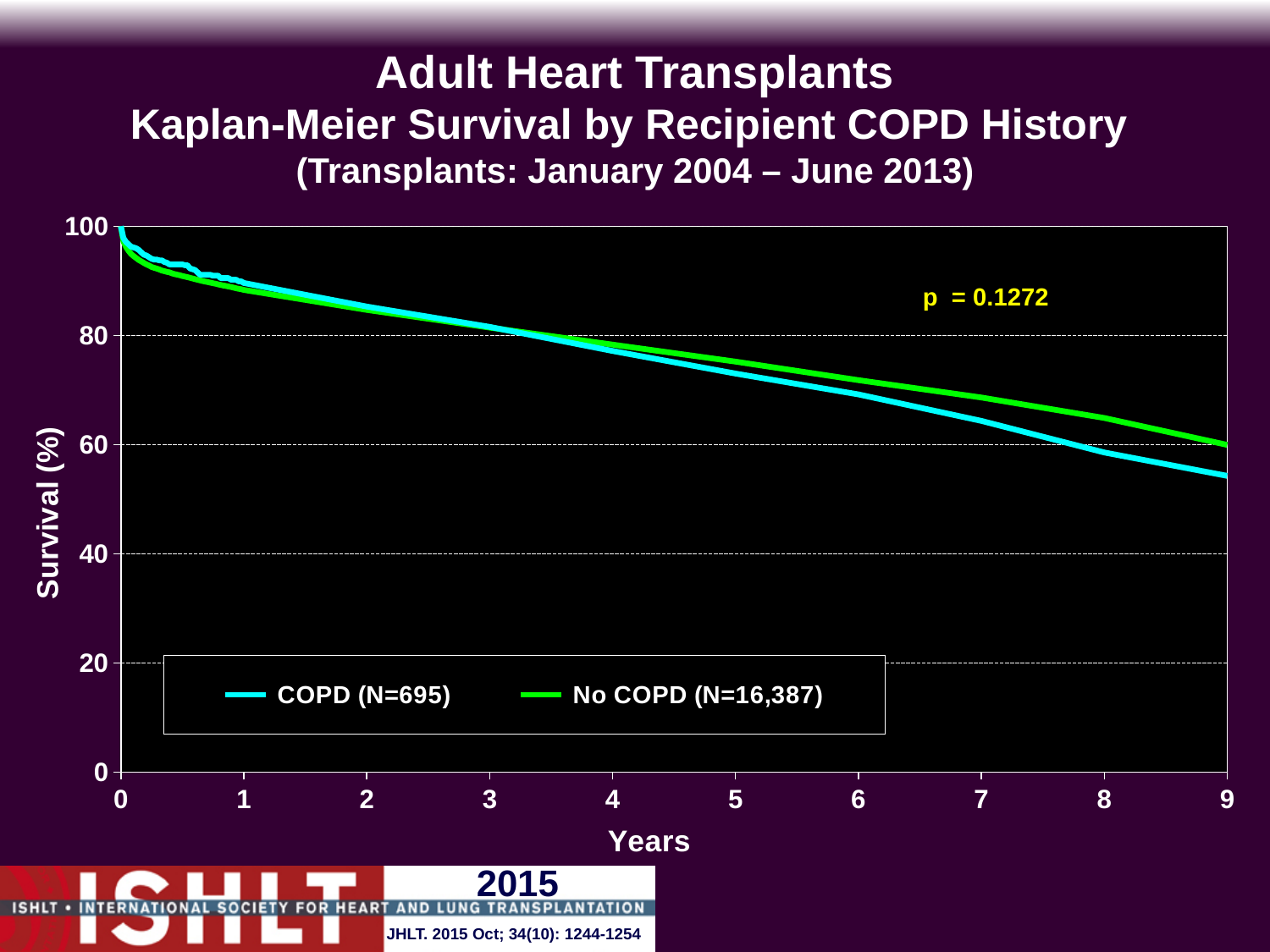
What kind of chart is shown on the slide? line chart How many series does the legend list? 2 What is the maximum value shown on the x axis (Years)? 9 Is the survival for the COPD group at 3 years greater or less than 60? greater Is the survival for the COPD group at 1 year greater or less than 80? greater What is the N for the No COPD group shown in the legend? 16,387 Is the survival for the No COPD group at 7 years greater or less than 80? less Do the survival curves rise or fall as the years increase? fall What is the p-value printed on the chart? p = 0.1272 At 9 years, which group has the higher survival, COPD or No COPD? No COPD